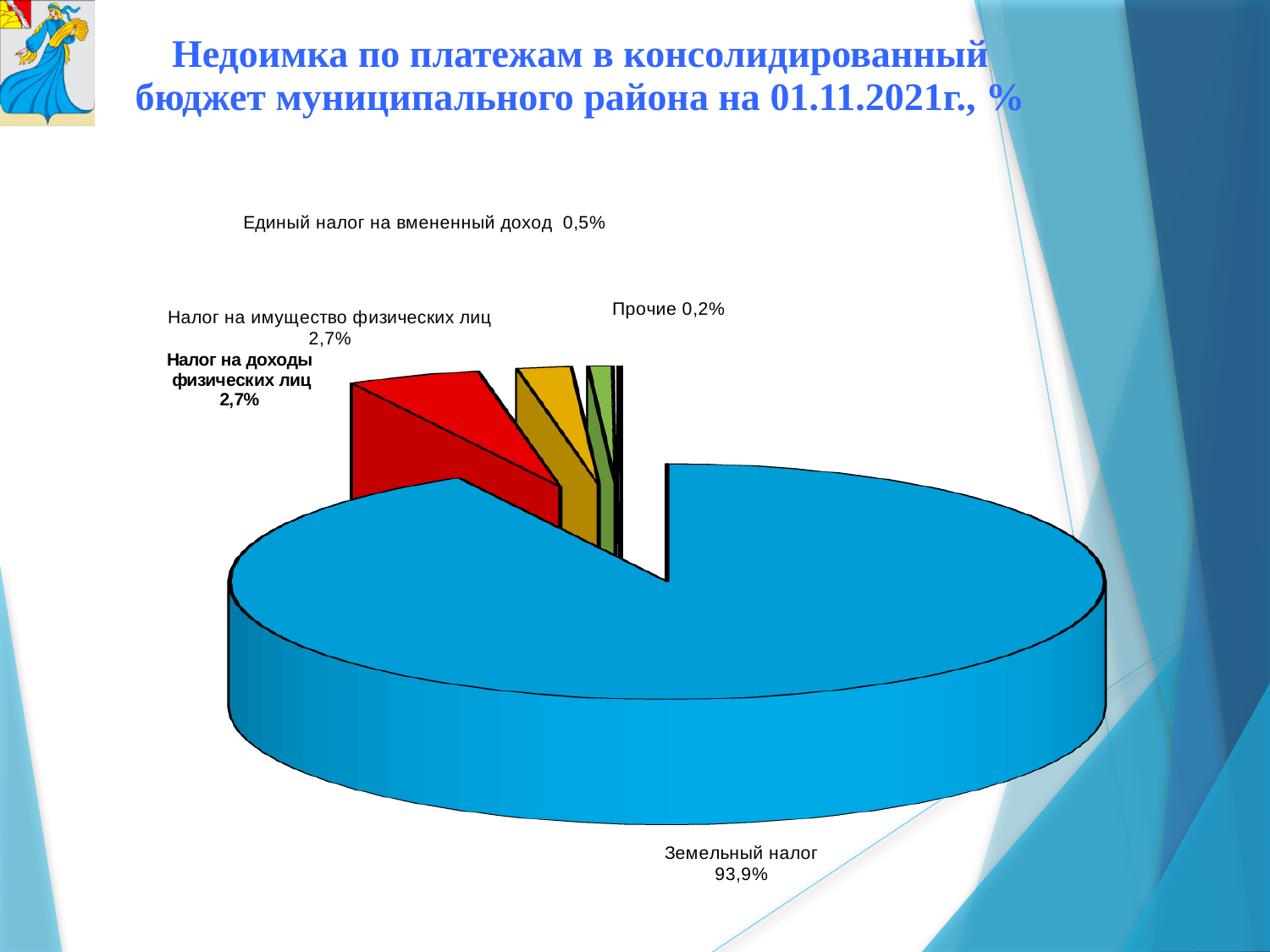
What is the difference between the values for Земельный налог and Налог на имущество физических лиц? 91,2% Which category has the largest share of the pie? Земельный налог What kind of chart is shown on the slide? Pie chart What is the value for Единый налог на вмененный доход? 0,5% Which category has the smallest share of the pie? Прочие What is the value for Земельный налог? 93,9% What is the value for Налог на доходы физических лиц? 2,7% What is the value for Прочие? 0,2% What is the value for Налог на имущество физических лиц? 2,7% Which is larger, the value for Единый налог на вмененный доход or the value for Прочие? Единый налог на вмененный доход How many slices does the pie chart have? 5 What colour is the slice for Земельный налог? Blue